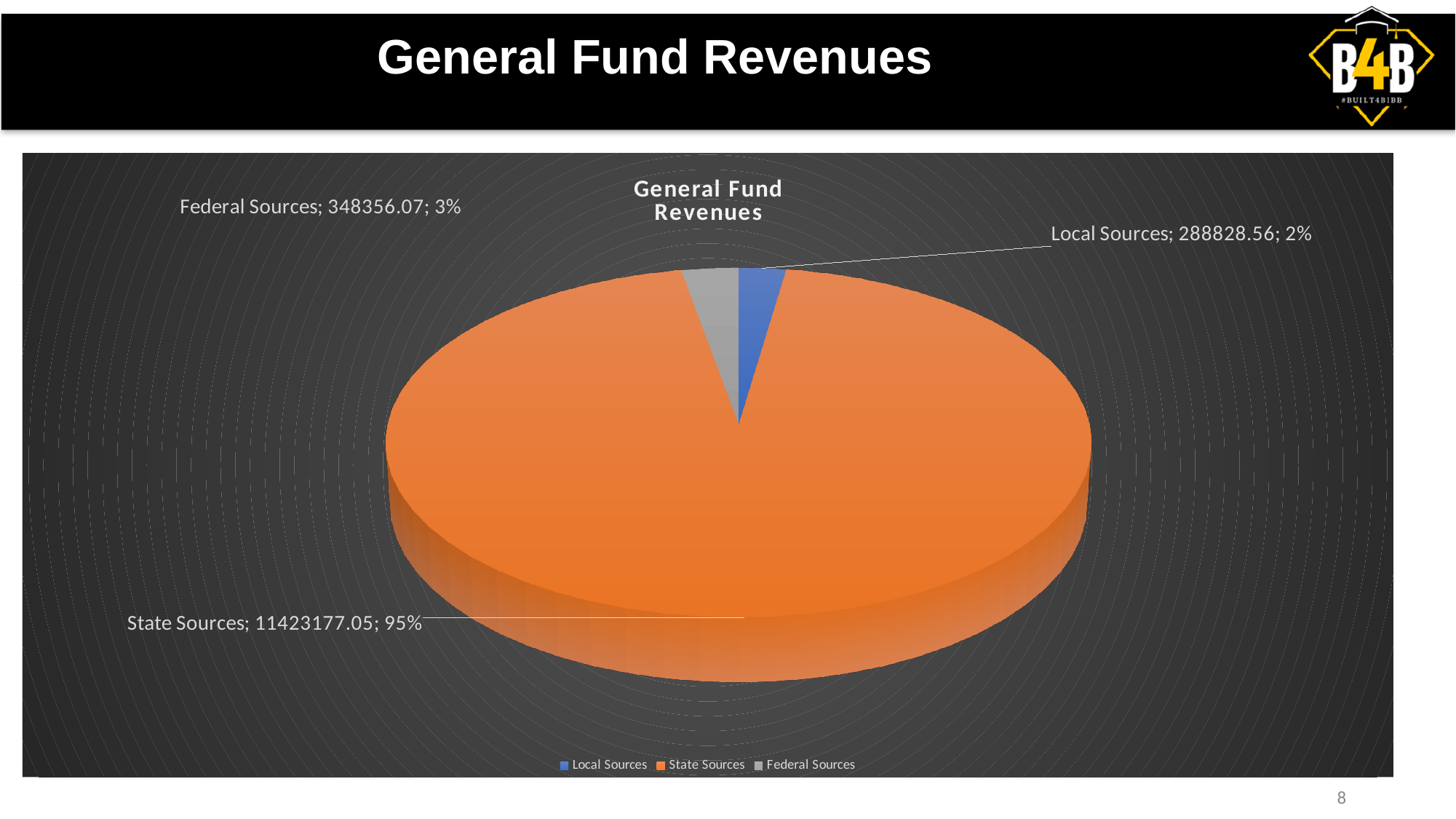
Which category has the smallest value? Local Sources What percentage share of the pie does Local Sources represent? 2% How many categories are shown in the pie chart? 3 What is the difference between the Federal Sources value and the Local Sources value? 59527.51 What percentage share of the pie does Federal Sources represent? 3% What is the value for Local Sources? 288828.56 Which category has the largest value? State Sources What is the value for Federal Sources? 348356.07 What is the value for State Sources? 11423177.05 Which is larger, Federal Sources or Local Sources? Federal Sources What percentage share of the pie does State Sources represent? 95% What type of chart is shown on the slide? Pie chart